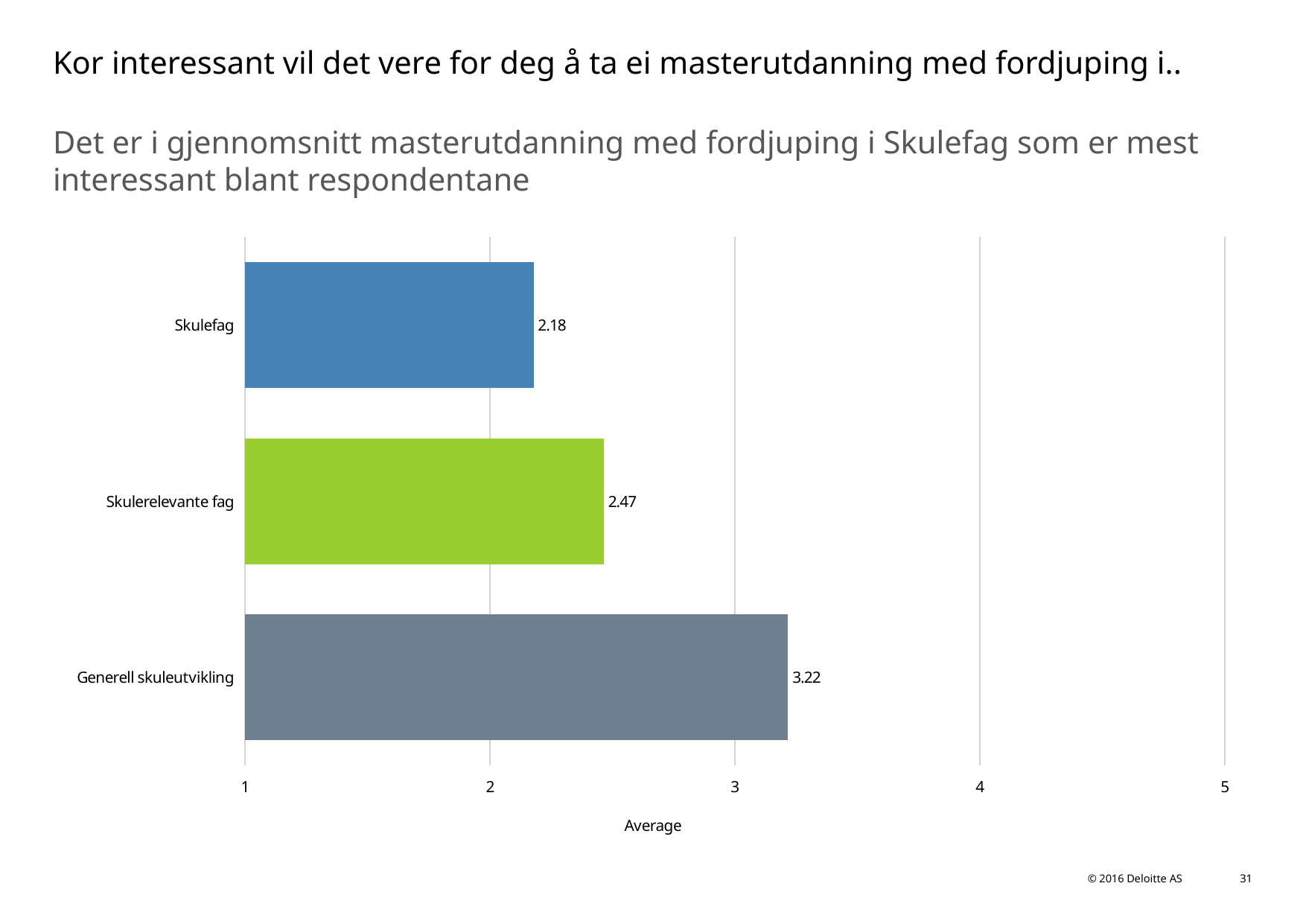
Which category has the highest average value? Generell skuleutvikling Which category has the lowest average value? Skulefag Is the value for Generell skuleutvikling greater or less than 3? greater What is the average value for Skulerelevante fag? 2.47 What is the average value for Generell skuleutvikling? 3.22 Which has a larger value, Skulerelevante fag or Generell skuleutvikling? Generell skuleutvikling What is the difference between the values for Skulerelevante fag and Skulefag? 0.29 What is the average value for Skulefag? 2.18 How many categories are shown in the chart? 3 What kind of chart is shown on the slide? Bar chart What is the label of the horizontal axis? Average What is the difference between the values for Generell skuleutvikling and Skulefag? 1.04